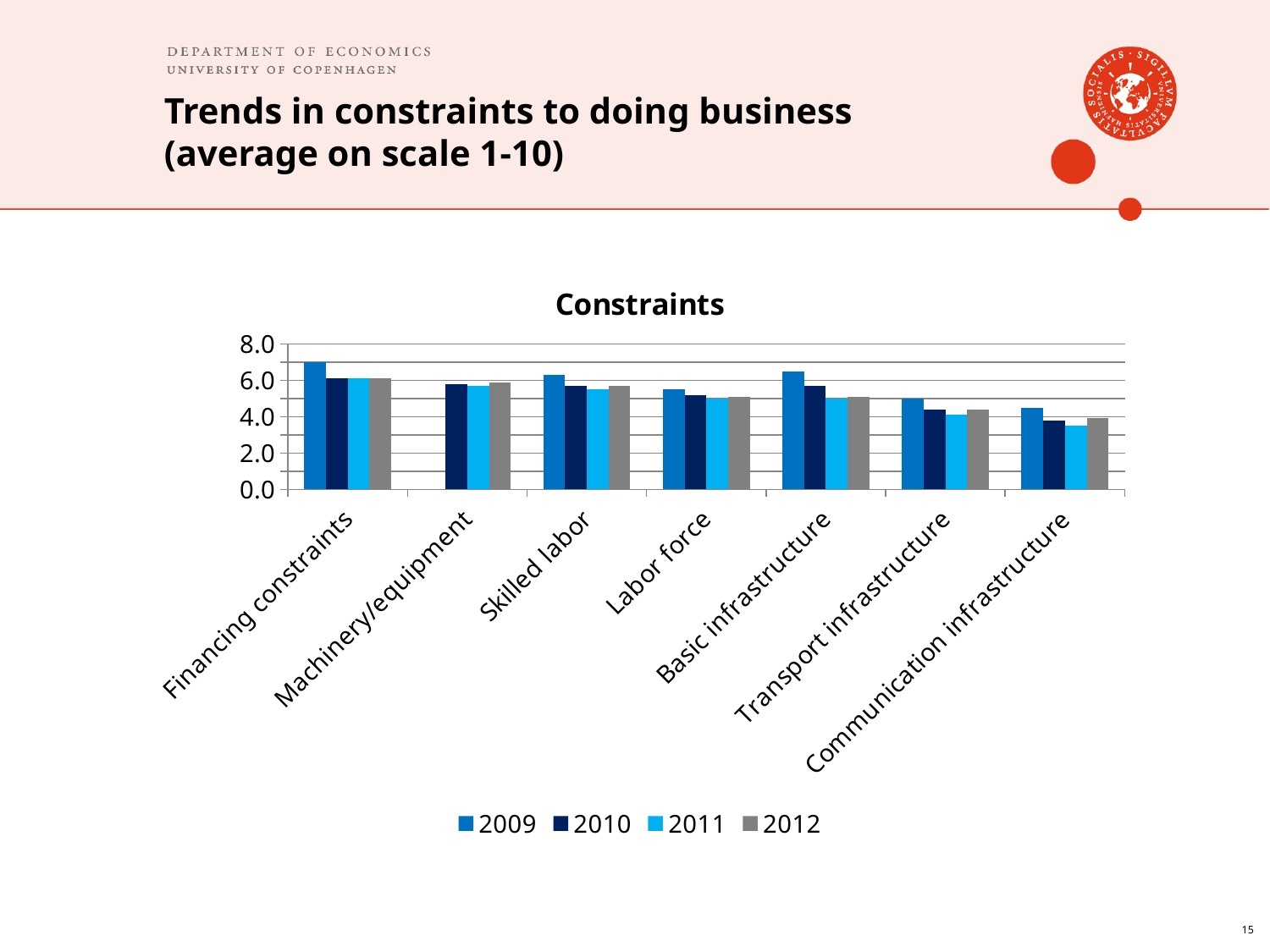
Which category has the lowest 2011 value? Communication infrastructure What kind of chart is shown on the slide? bar chart How many constraint categories are shown on the x axis of the chart? 7 Which is larger, the 2009 value for Financing constraints or the 2009 value for Communication infrastructure? Financing constraints How many series does the chart's legend list? 4 Is the 2009 value for Financing constraints greater or less than 6.0? greater Is the 2011 value for Transport infrastructure greater or less than 6.0? less Is the 2009 value for Basic infrastructure greater or less than 6.0? greater What is the title of the chart? Constraints Which category has the highest 2009 value? Financing constraints Which years are listed in the chart's legend? 2009, 2010, 2011, 2012